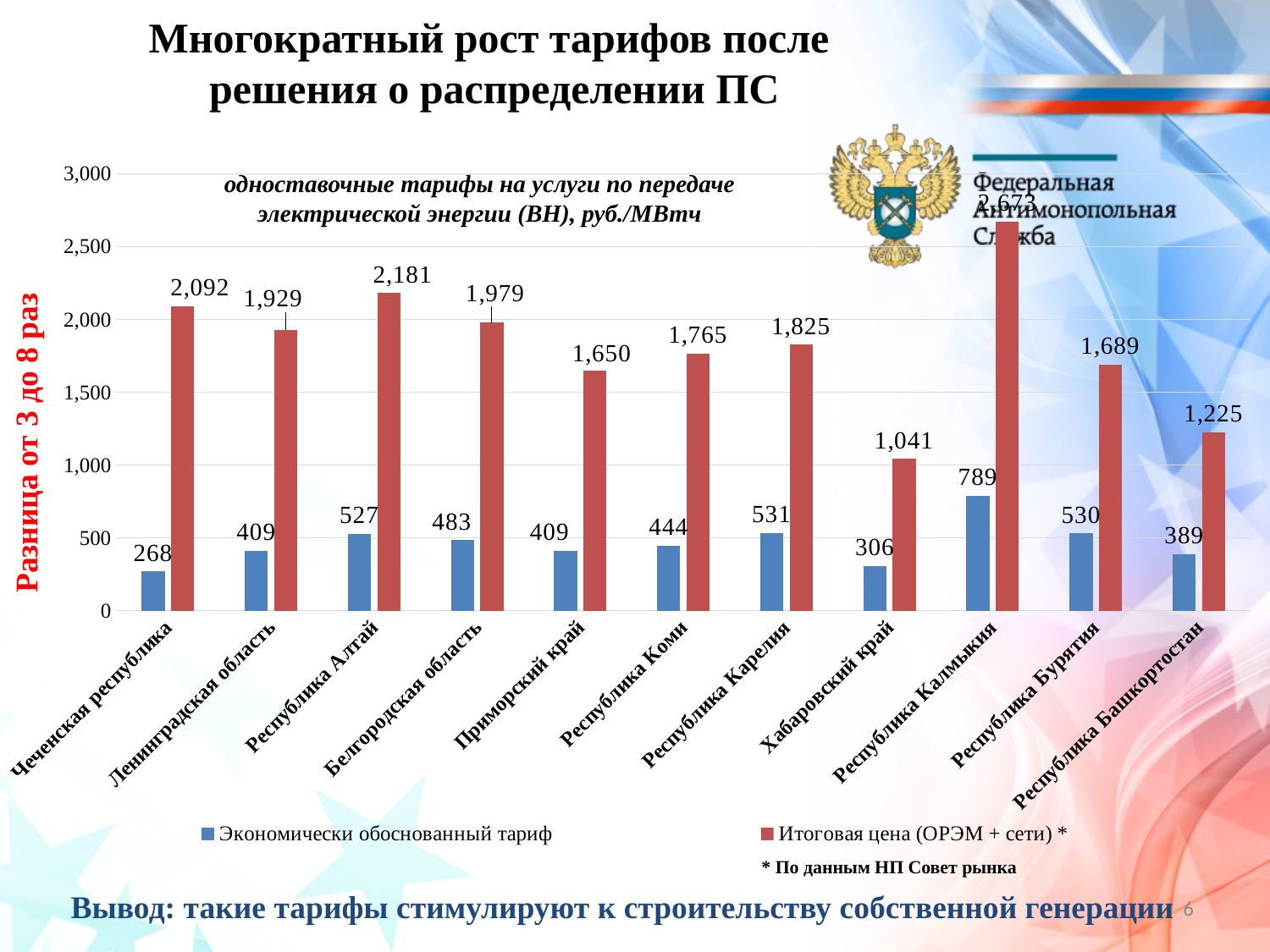
What is the value of 'Экономически обоснованный тариф' for Республика Калмыкия? 789 Which is larger: 'Итоговая цена (ОРЭМ + сети)' for Республика Бурятия or for Республика Башкортостан? Республика Бурятия How many series does the chart legend list? 2 Which region has the lowest value of 'Итоговая цена (ОРЭМ + сети)'? Хабаровский край Which region has the highest value of 'Экономически обоснованный тариф'? Республика Калмыкия What is the value of 'Экономически обоснованный тариф' for Чеченская республика? 268 What is the difference between 'Итоговая цена (ОРЭМ + сети)' and 'Экономически обоснованный тариф' for Белгородская область? 1,496 What is the value of 'Итоговая цена (ОРЭМ + сети)' for Республика Алтай? 2,181 What type of chart is shown on the slide? bar chart Which series is shown in red in the chart? Итоговая цена (ОРЭМ + сети) * How many regions (categories) are shown on the x axis of the chart? 11 What is the value of 'Итоговая цена (ОРЭМ + сети)' for Хабаровский край? 1,041